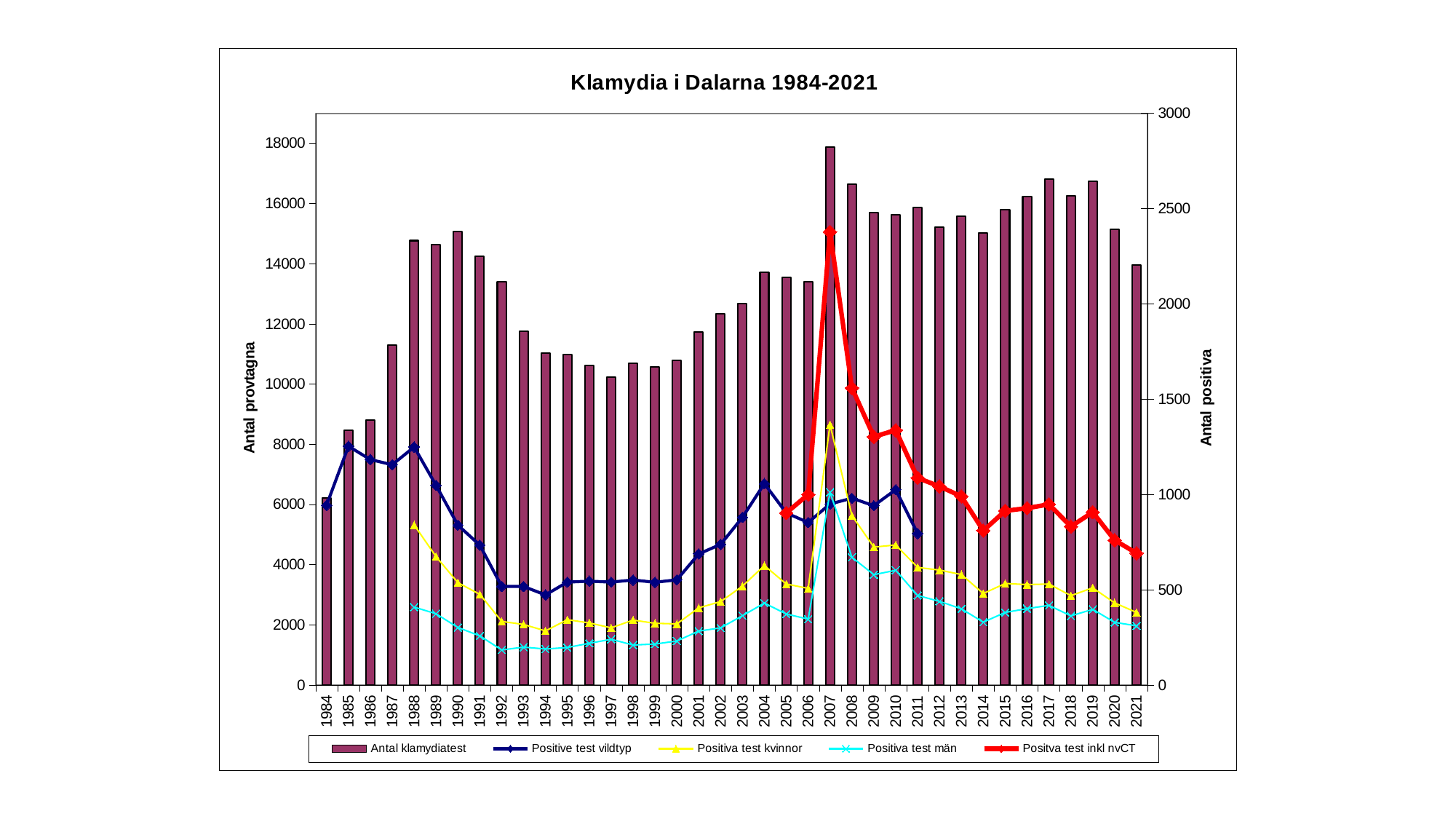
What is the title of the chart? Klamydia i Dalarna 1984-2021 Is the Antal klamydiatest value for 1984 greater or less than 8000? less In which year is the Antal klamydiatest bar highest? 2007 How many series does the legend list? 5 How many years are shown on the x axis? 38 Is the Antal klamydiatest value for 2007 greater or less than 16000? greater Does the Positiva test inkl nvCT line generally rise or fall from 2007 to 2021? fall Which year has the higher Antal klamydiatest bar, 2007 or 2008? 2007 In which year does the Positiva test inkl nvCT line reach its peak? 2007 Is the Antal klamydiatest value for 1997 greater or less than 12000? less In which year is the Antal klamydiatest bar lowest? 1984 What kind of chart is used for the Antal klamydiatest series? bar chart